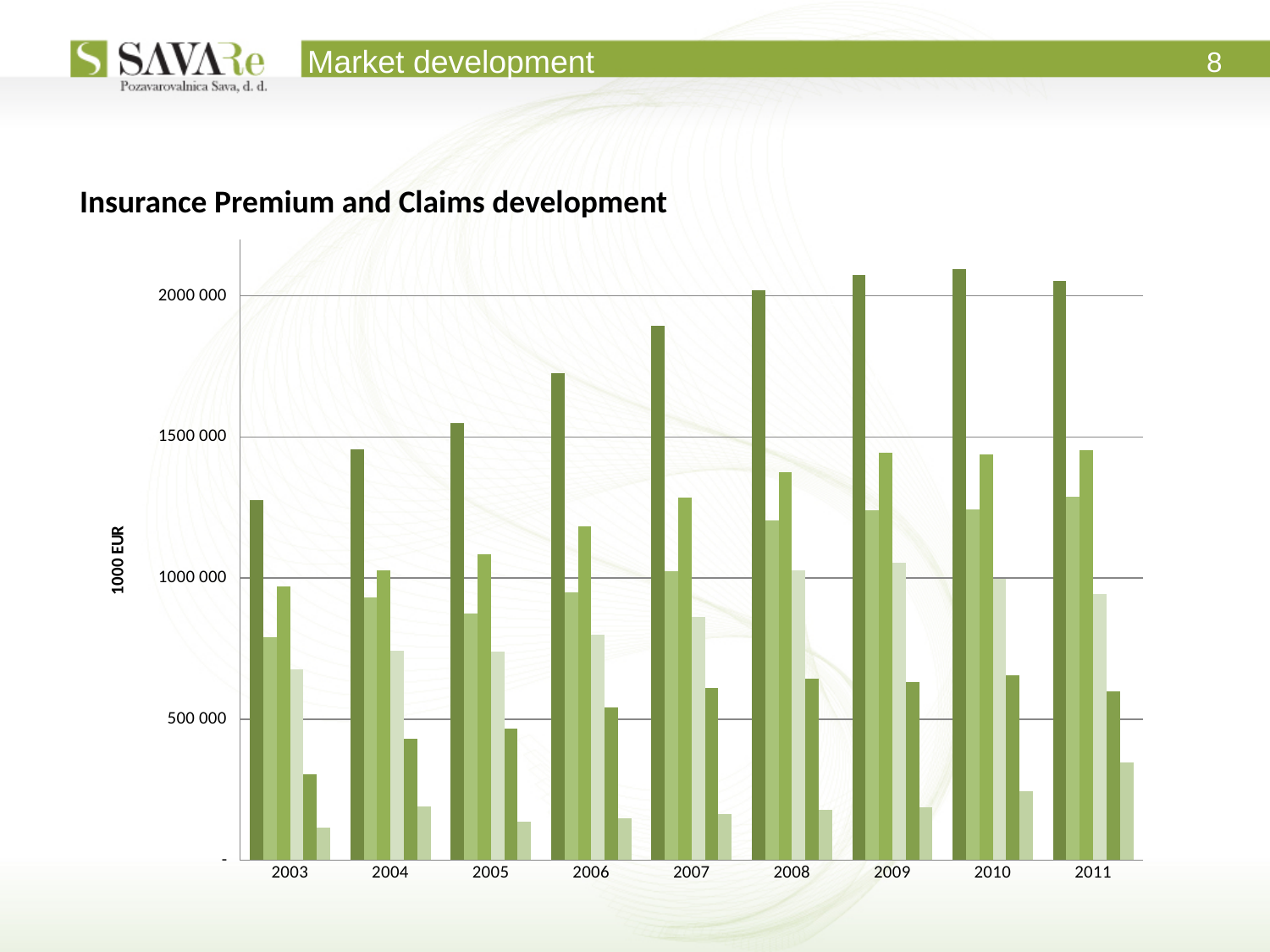
In which year is the tallest (first) bar of the group the lowest? 2003 How many years are shown on the x axis of the chart? 9 Is the tallest bar for 2007 greater or less than 2000 000? less What kind of chart is shown on the slide? bar chart Is the tallest bar for 2005 greater or less than 1500 000? greater Is the tallest bar for 2003 greater or less than 1500 000? less What is the label on the vertical axis of the chart? 1000 EUR Is the first (darkest) bar for 2006 larger or smaller than the first bar for 2004? larger What is the title of the chart? Insurance Premium and Claims development Does the first (darkest) bar in each group rise or fall from 2003 to 2008? rise